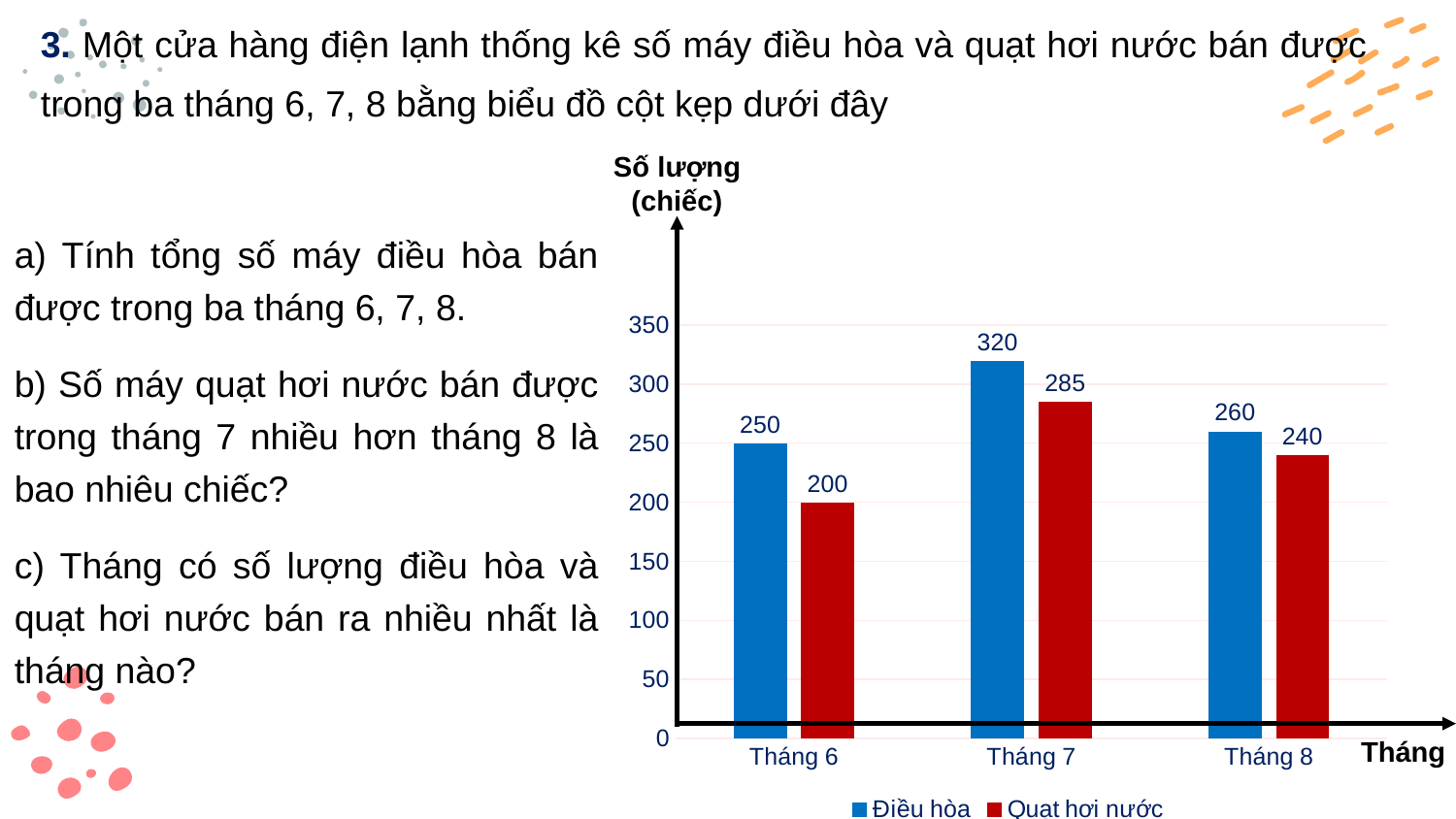
Which month has the lowest value for Quạt hơi nước? Tháng 6 How many months are shown on the x axis? 3 What is the value for Điều hòa in Tháng 8? 260 What kind of chart is shown on the slide? Bar chart Which is larger in Tháng 8: Điều hòa or Quạt hơi nước? Điều hòa What is the difference between Quạt hơi nước sold in Tháng 7 and Tháng 8? 45 What colour are the Quạt hơi nước bars? Red How many units of Điều hòa were sold in Tháng 7? 320 What is the total of Điều hòa sold across Tháng 6, Tháng 7 and Tháng 8? 830 How many series does the legend list? 2 Which month has the highest value for Điều hòa? Tháng 7 What is the value for Quạt hơi nước in Tháng 6? 200